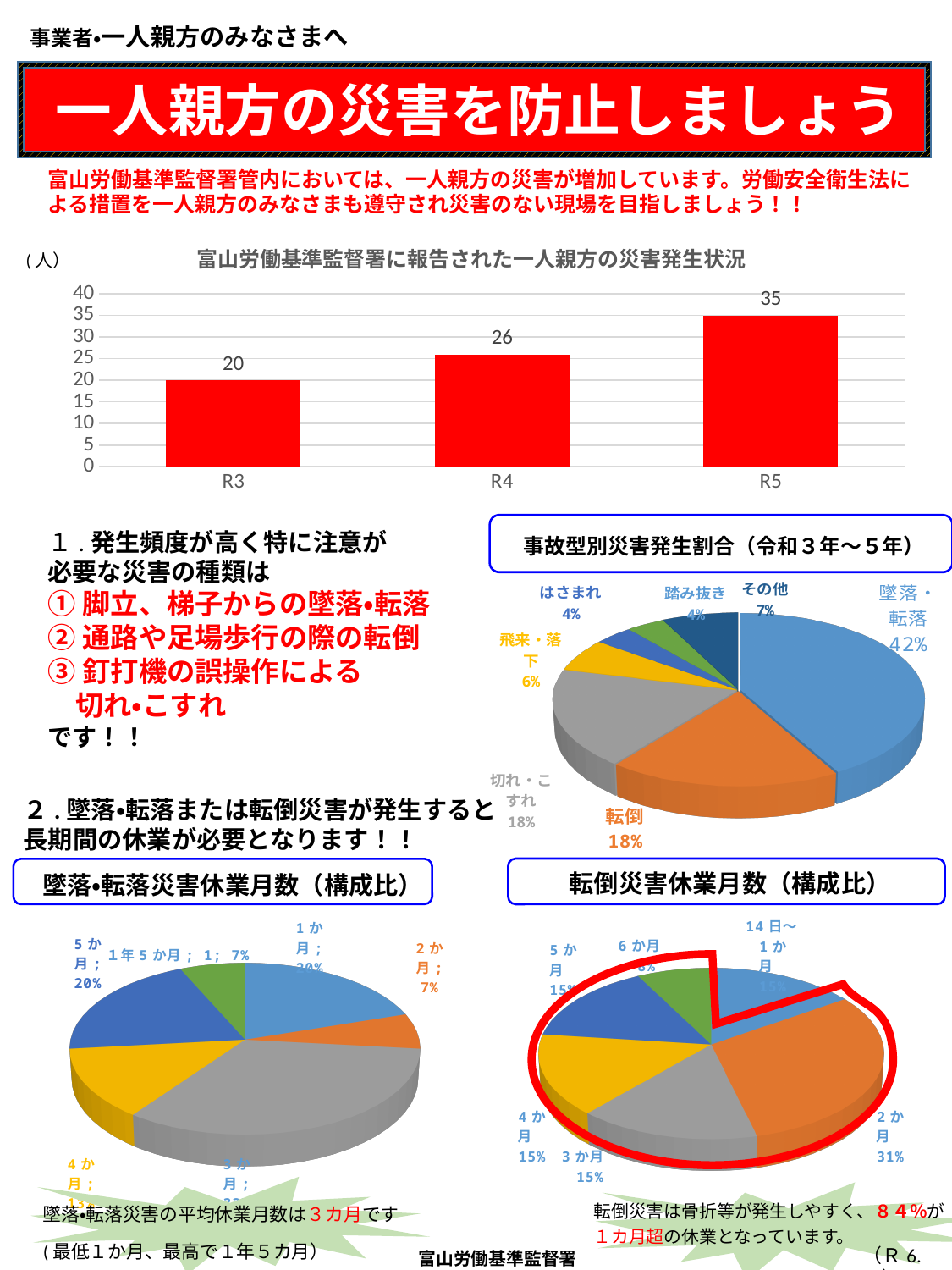
In the bar chart titled 富山労働基準監督署に報告された一人親方の災害発生状況, how many bars are plotted? 3 In the pie chart titled 墜落・転落災害休業月数（構成比）, what share does 5か月 have? 20% What kind of chart is the chart titled 富山労働基準監督署に報告された一人親方の災害発生状況? bar chart In the bar chart titled 富山労働基準監督署に報告された一人親方の災害発生状況, what is the value for R3? 20 In the pie chart titled 転倒災害休業月数（構成比）, what share does 2か月 have? 31% In the pie chart titled 事故型別災害発生割合（令和３年～５年）, which category has the largest share? 墜落・転落 In the bar chart titled 富山労働基準監督署に報告された一人親方の災害発生状況, what is the value for R5? 35 In the bar chart titled 富山労働基準監督署に報告された一人親方の災害発生状況, which year has the highest value? R5 In the bar chart titled 富山労働基準監督署に報告された一人親方の災害発生状況, do the values rise or fall from R3 to R5? rise In the pie chart titled 事故型別災害発生割合（令和３年～５年）, what share does 飛来・落下 have? 6% In the bar chart titled 富山労働基準監督署に報告された一人親方の災害発生状況, what is the difference between the values for R5 and R4? 9